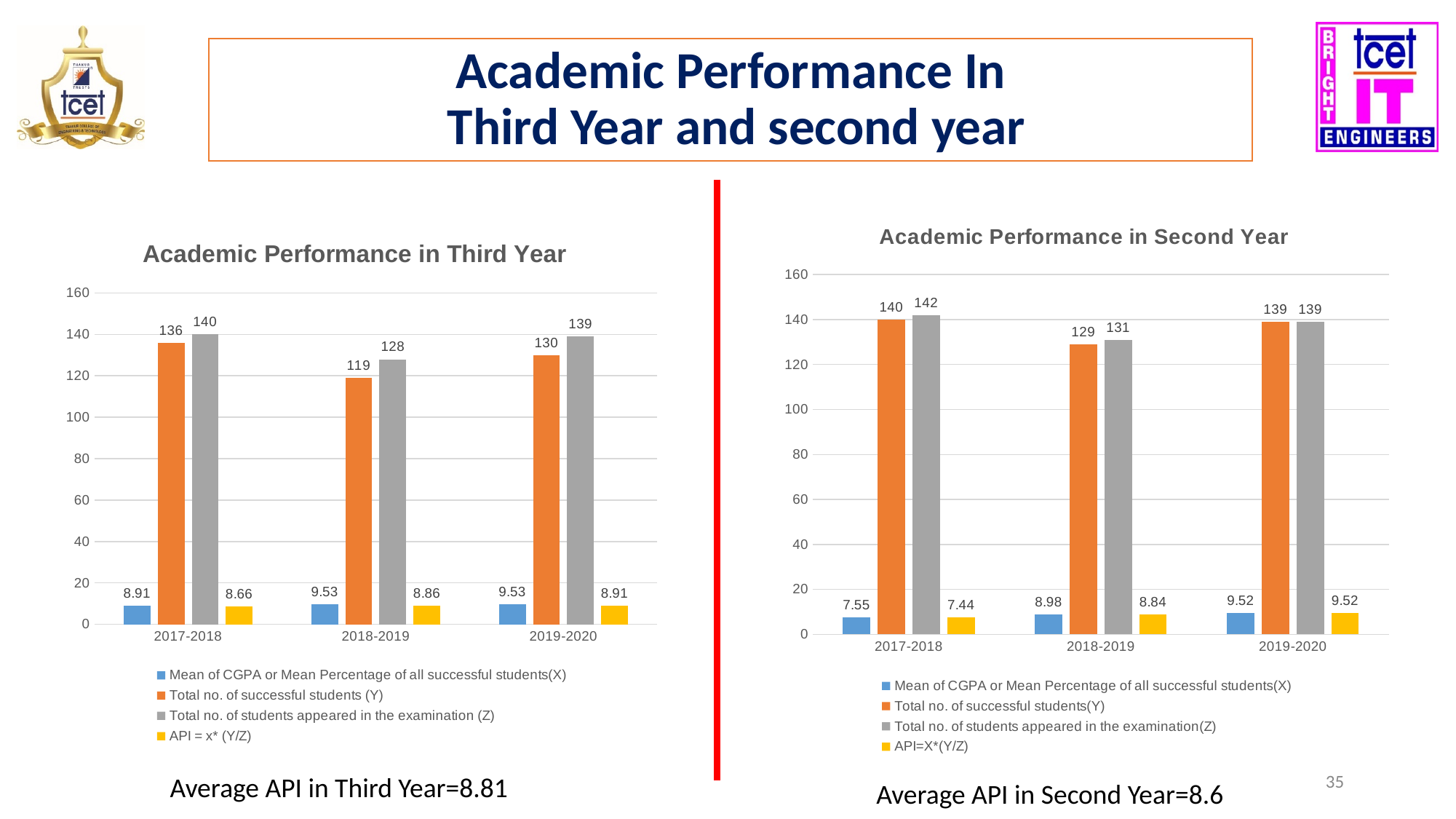
How many series does the legend of the 'Academic Performance in Second Year' chart list? 4 In the 'Academic Performance in Third Year' chart, what is the difference between students appeared (Z) and successful students (Y) in 2019-2020? 9 In the 'Academic Performance in Second Year' chart, what is the difference between students appeared (Z) and successful students (Y) in 2018-2019? 2 What type of chart is 'Academic Performance in Second Year'? Bar chart In the 'Academic Performance in Third Year' chart, what is the total number of successful students (Y) for 2018-2019? 119 In the 'Academic Performance in Second Year' chart, which year has the highest total number of students appeared in the examination (Z)? 2017-2018 In the 'Academic Performance in Second Year' chart, what is the total number of students appeared in the examination (Z) for 2017-2018? 142 How many academic years are shown on the x axis of the 'Academic Performance in Third Year' chart? 3 In the 'Academic Performance in Third Year' chart, is the API for 2017-2018 or 2018-2019 larger? 2018-2019 In the 'Academic Performance in Third Year' chart, which year has the lowest total number of successful students (Y)? 2018-2019 In the 'Academic Performance in Second Year' chart, what is the mean CGPA (X) for 2017-2018? 7.55 In the 'Academic Performance in Third Year' chart, what is the API value for 2019-2020? 8.91